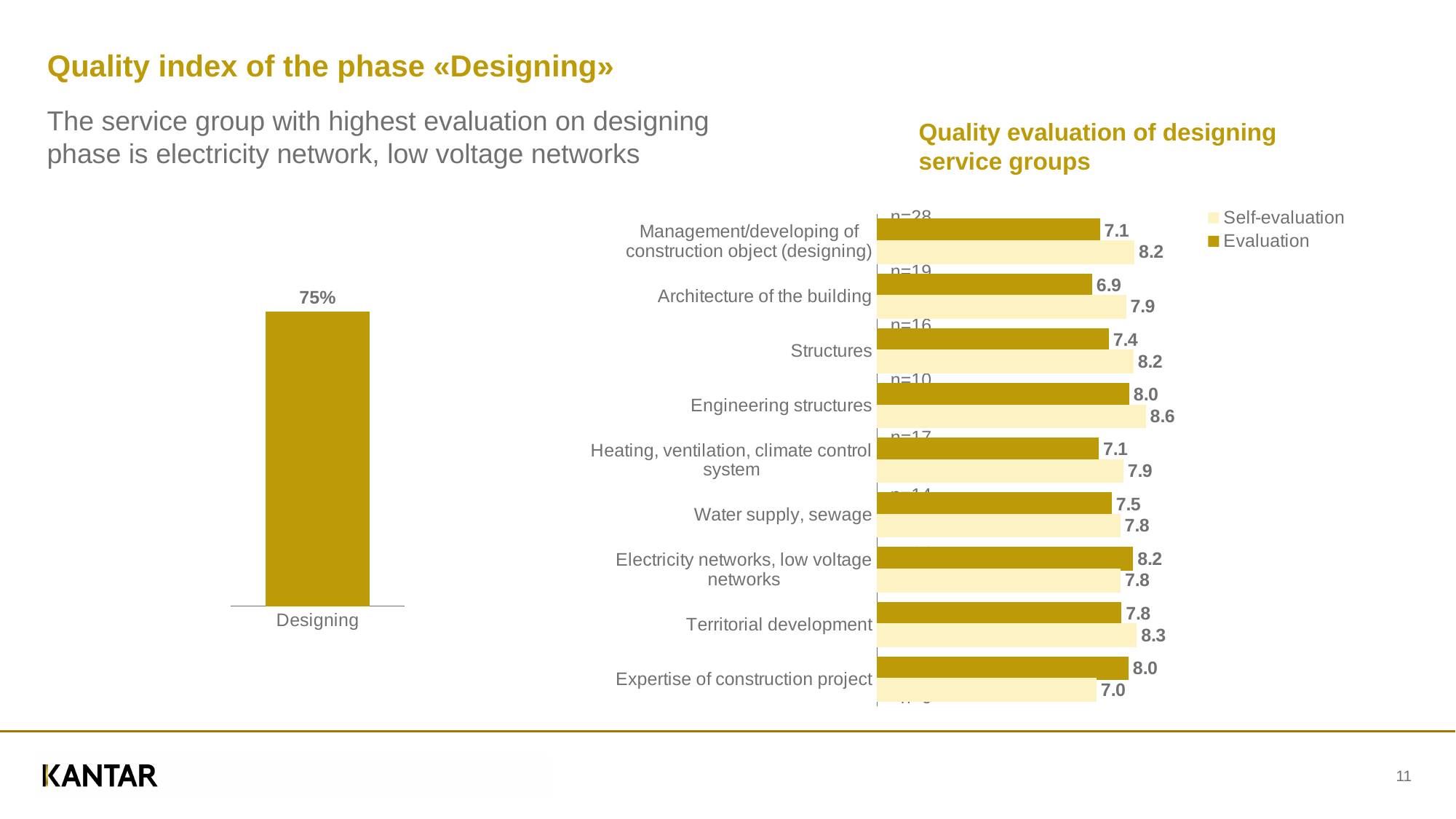
On the 'Quality evaluation of designing service groups' chart, what is the Self-evaluation value for Engineering structures? 8.6 On the 'Quality evaluation of designing service groups' chart, how many series does the legend list? 2 On the left chart, what is the value shown for Designing? 75% On the 'Quality evaluation of designing service groups' chart, which service group has the lowest Self-evaluation value? Expertise of construction project On the 'Quality evaluation of designing service groups' chart, which service group has the lowest Evaluation value? Architecture of the building On the 'Quality evaluation of designing service groups' chart, which is larger for Expertise of construction project: Evaluation or Self-evaluation? Evaluation On the 'Quality evaluation of designing service groups' chart, which series is shown in the darker gold colour? Evaluation On the 'Quality evaluation of designing service groups' chart, what is the Evaluation value for Architecture of the building? 6.9 On the 'Quality evaluation of designing service groups' chart, how many service groups are listed? 9 On the 'Quality evaluation of designing service groups' chart, what is the difference between the Self-evaluation and Evaluation values for Management/developing of construction object (designing)? 1.1 On the 'Quality evaluation of designing service groups' chart, which service group has the highest Evaluation value? Electricity networks, low voltage networks What type of chart is the 'Quality evaluation of designing service groups' chart? Bar chart